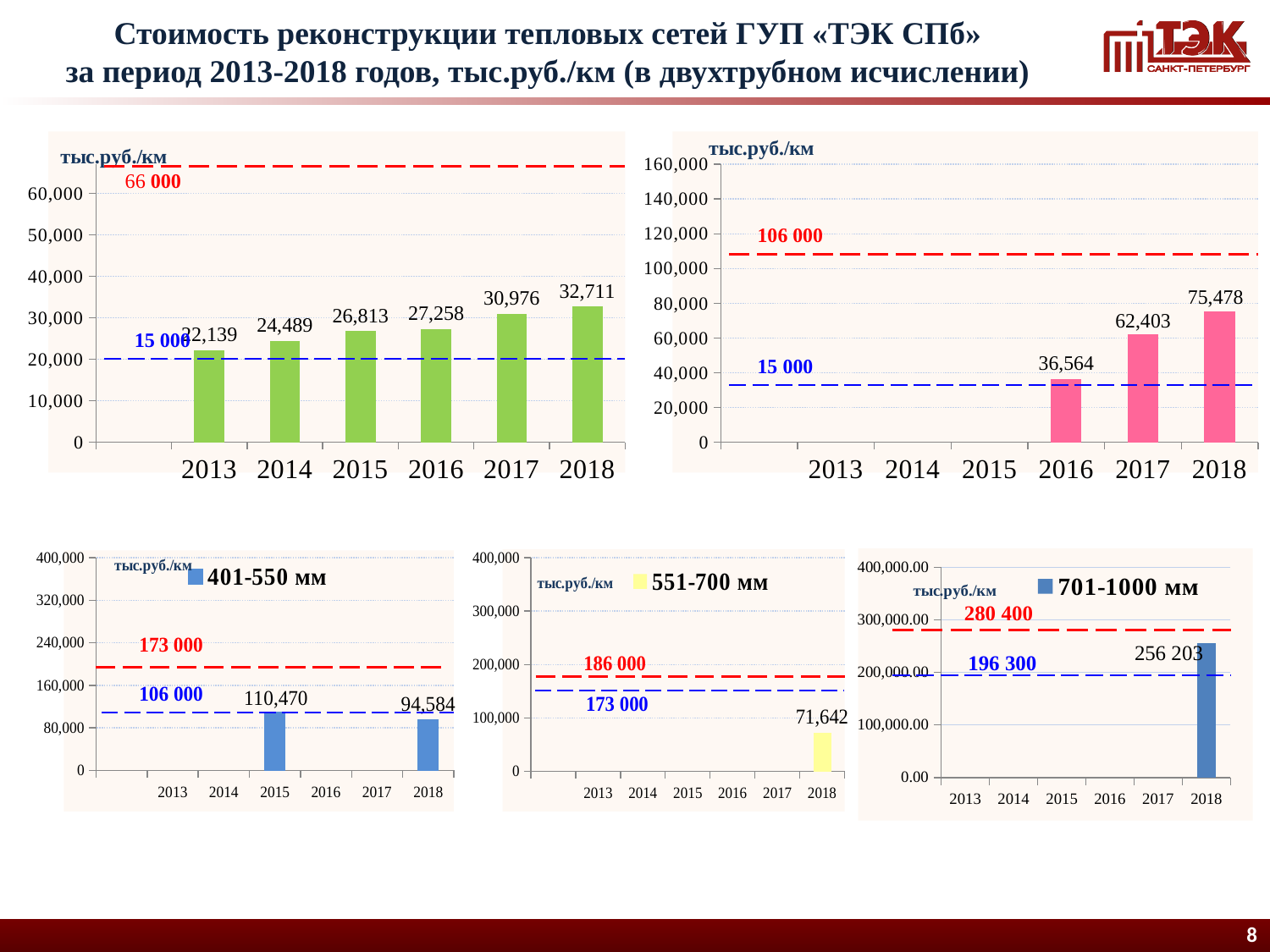
In the top-left chart, what is the difference between the 2018 and 2013 values? 10,572 In the bottom-left chart (401-550 мм), what is the value for 2018? 94,584 In the bottom-right chart (701-1000 мм), what is the value for 2018? 256 203 In the bottom-middle chart (551-700 мм), what is the value for 2018? 71,642 In the top-right chart, how many years have a bar plotted? 3 In the top-left chart, what is the value for 2013? 22,139 In the top-left chart, do the values rise or fall from 2013 to 2018? rise In the bottom-left chart (401-550 мм), which year has the larger value, 2015 or 2018? 2015 In the top-left chart, which year has the highest value? 2018 In the top-right chart, what is the value for 2017? 62,403 In the top-right chart, what is the difference between the 2018 and 2016 values? 38,914 In the top-left chart, what is the value for 2018? 32,711